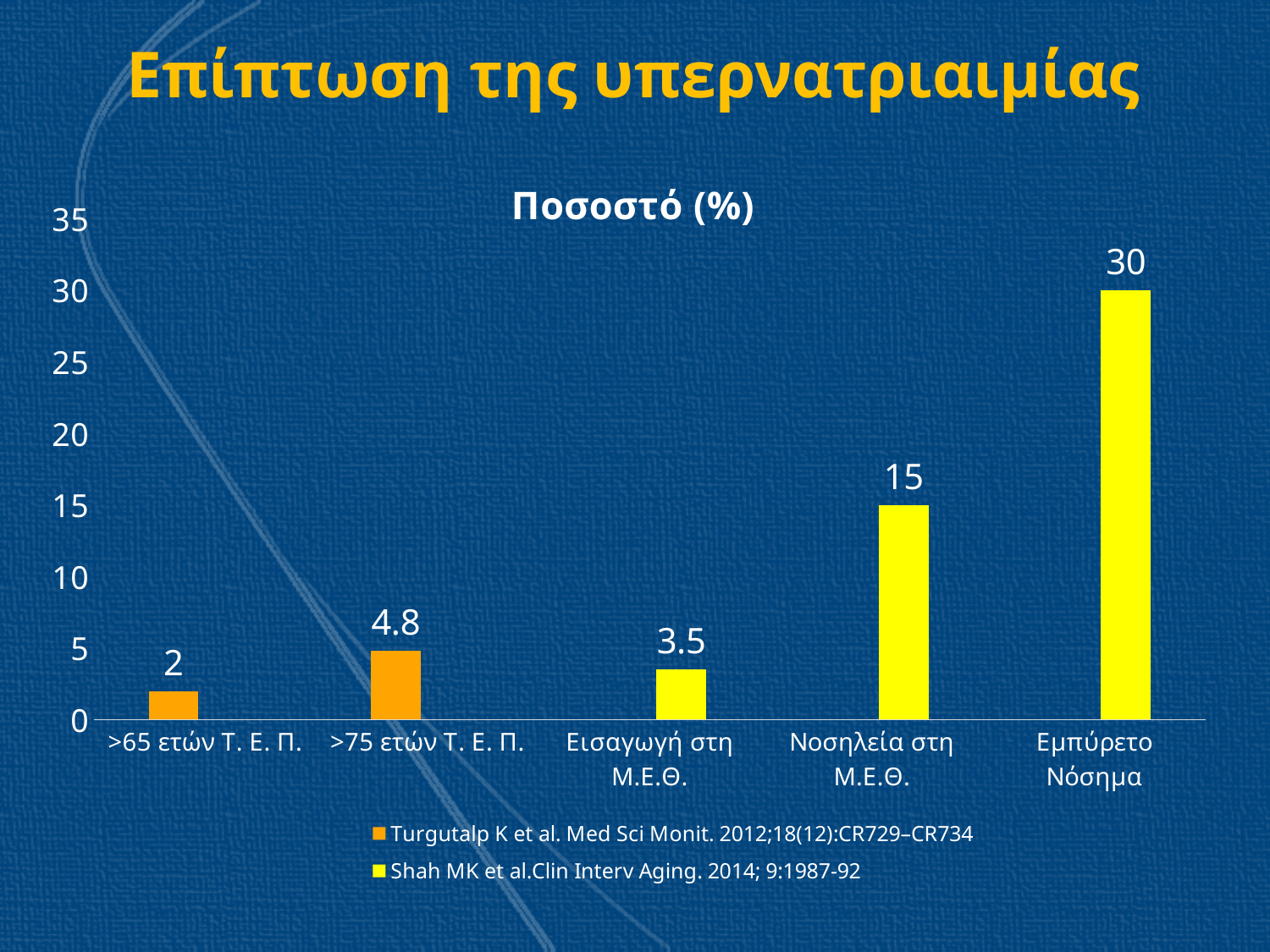
What is the value for >75 ετών Τ. Ε. Π.? 4.8 What is the value for Εμπύρετο Νόσημα? 30 What is the difference between the values for Εμπύρετο Νόσημα and Νοσηλεία στη Μ.Ε.Θ.? 15 Which is larger, the value for >75 ετών Τ. Ε. Π. or the value for Εισαγωγή στη Μ.Ε.Θ.? >75 ετών Τ. Ε. Π. What is the value for Εισαγωγή στη Μ.Ε.Θ.? 3.5 How many categories are shown on the x axis? 5 What is the title of the chart? Ποσοστό (%) What is the difference between the values for >75 ετών Τ. Ε. Π. and >65 ετών Τ. Ε. Π.? 2.8 How many series does the legend list? 2 What kind of chart is shown on the slide? Bar chart Which category has the lowest value? >65 ετών Τ. Ε. Π. Which category has the highest value? Εμπύρετο Νόσημα